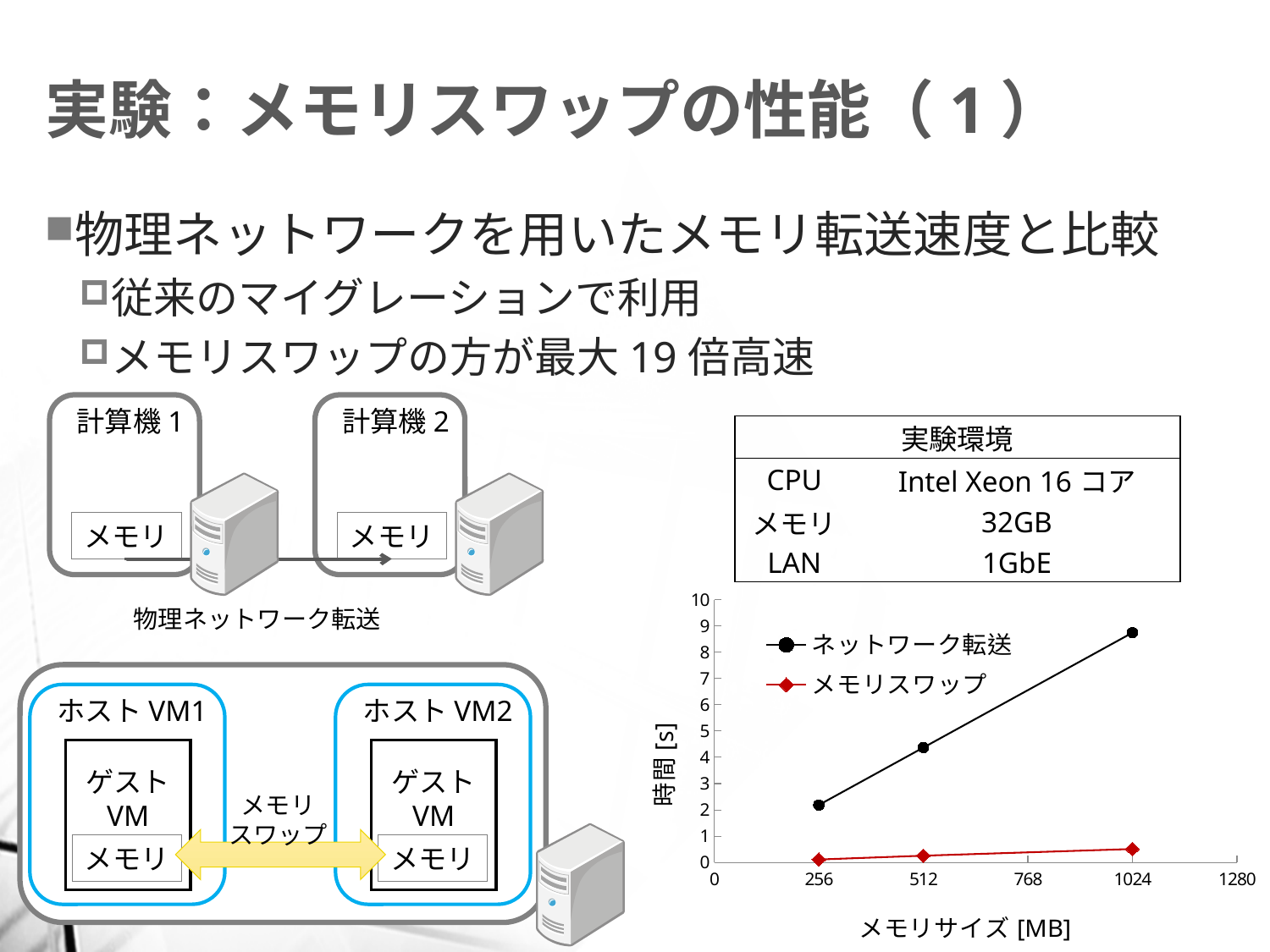
What kind of chart is shown on the slide? line chart How many series does the chart's legend list? 2 What is the label of the chart's x axis? メモリサイズ [MB] Is the value for ネットワーク転送 at 1024 MB greater or less than 8? greater At which memory size is the ネットワーク転送 time highest? 1024 How many data points are plotted for the ネットワーク転送 series? 3 Is the value for メモリスワップ at 1024 MB greater or less than 1? less Is the value for ネットワーク転送 at 512 MB greater or less than 4? greater Does the time for ネットワーク転送 rise or fall as memory size increases along the x axis? rise Which series has the higher time at 1024 MB, ネットワーク転送 or メモリスワップ? ネットワーク転送 What is the label of the chart's y axis? 時間 [s]